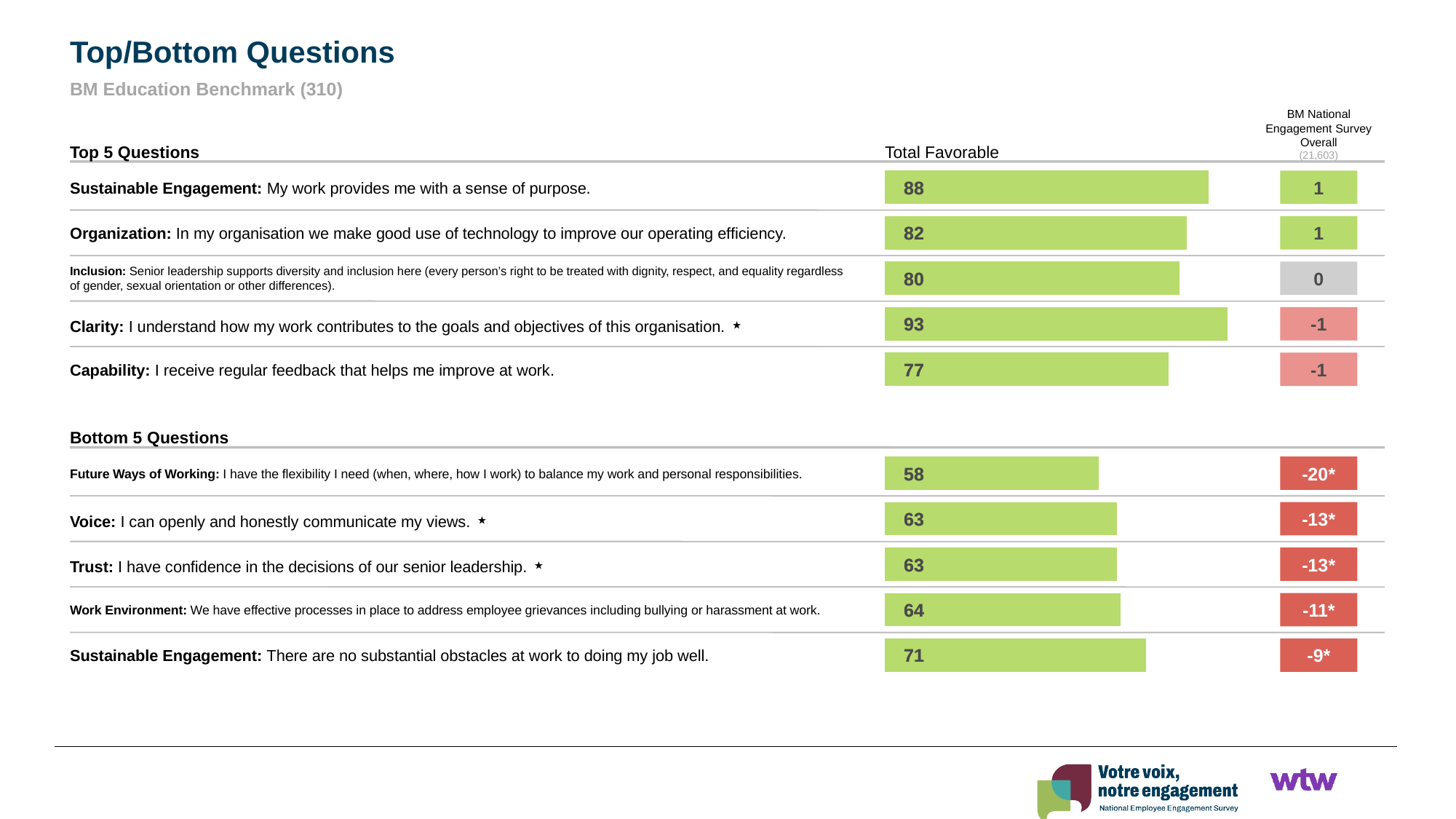
In the Top 5 Questions chart, what is the difference in Total Favorable between the Clarity question and the Capability question? 16 In the Top 5 Questions chart, what is the BM National Engagement Survey Overall comparison value for the Inclusion question? 0 In the Bottom 5 Questions chart, what is the BM National Engagement Survey Overall comparison value for the Voice question? -13* In the Top 5 Questions chart, which has a higher Total Favorable value: the Organization question or the Inclusion question? Organization In the Top 5 Questions chart, what is the Total Favorable value for the Clarity question? 93 In the Top 5 Questions chart, what is the Total Favorable value for the Capability question? 77 How many questions are shown in the Bottom 5 Questions chart? 5 In the Bottom 5 Questions chart, what is the Total Favorable value for the Future Ways of Working question? 58 In the Bottom 5 Questions chart, which question has the lowest Total Favorable value? Future Ways of Working What kind of chart is used to show the Total Favorable values on this slide? Bar chart In the Top 5 Questions chart, which question has the highest Total Favorable value? Clarity In the Bottom 5 Questions chart, what is the difference in Total Favorable between the Sustainable Engagement question and the Future Ways of Working question? 13